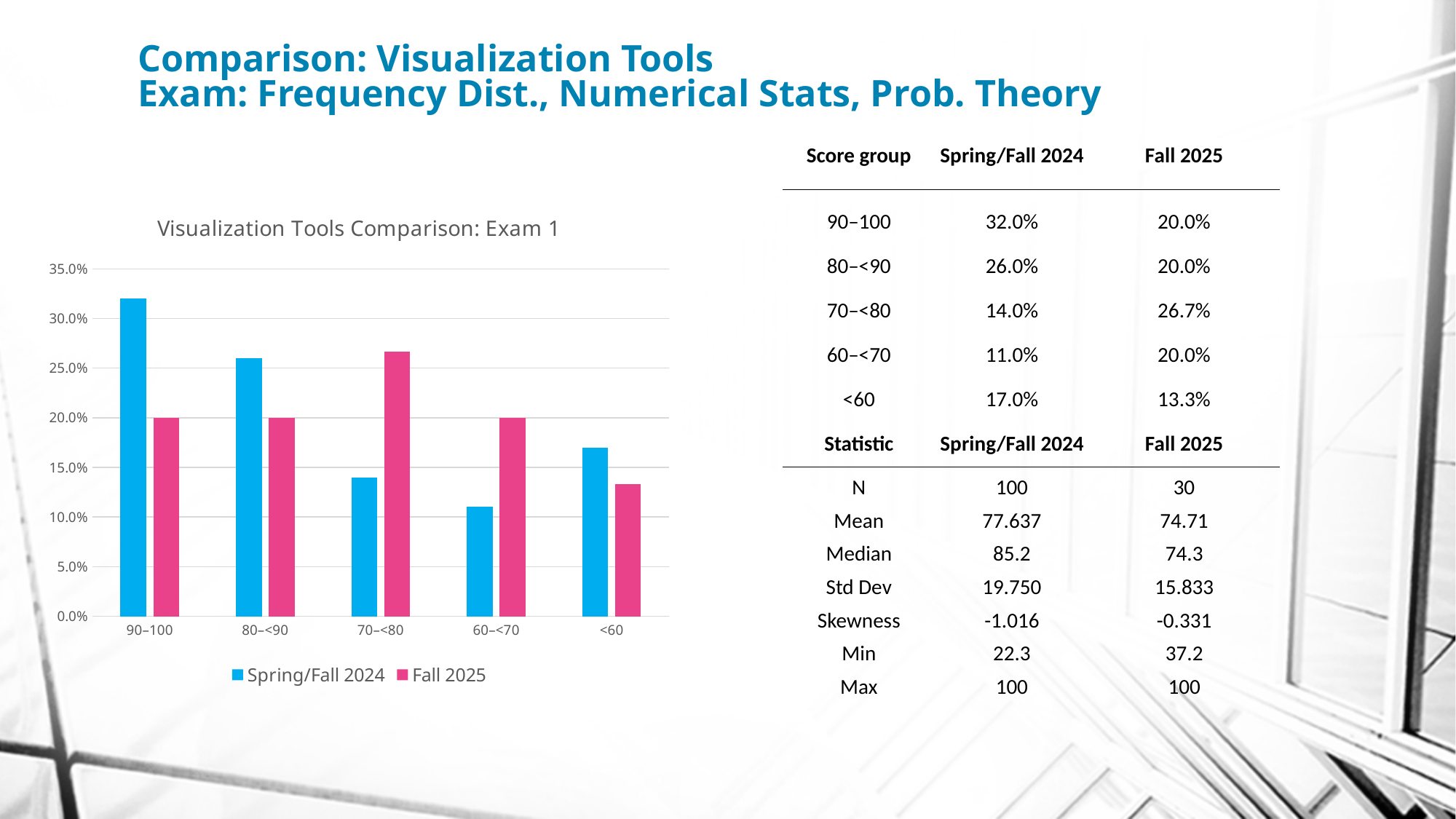
Which score group has the lowest Fall 2025 value? <60 What is the Fall 2025 value for the 70–<80 score group? 26.7% What is the difference between the Spring/Fall 2024 and Fall 2025 values for the 90–100 score group? 12.0% Is the Spring/Fall 2024 value for the <60 score group greater or less than 15.0%? greater For the 70–<80 score group, which series has the larger value, Spring/Fall 2024 or Fall 2025? Fall 2025 What is the title of the chart? Visualization Tools Comparison: Exam 1 What is the Spring/Fall 2024 value for the 90–100 score group? 32.0% Which score group has the lowest Spring/Fall 2024 value? 60–<70 How many series does the chart legend list? 2 What type of chart is shown on the slide? bar chart How many score-group categories are shown on the x axis of the chart? 5 Which score group has the highest Spring/Fall 2024 value? 90–100